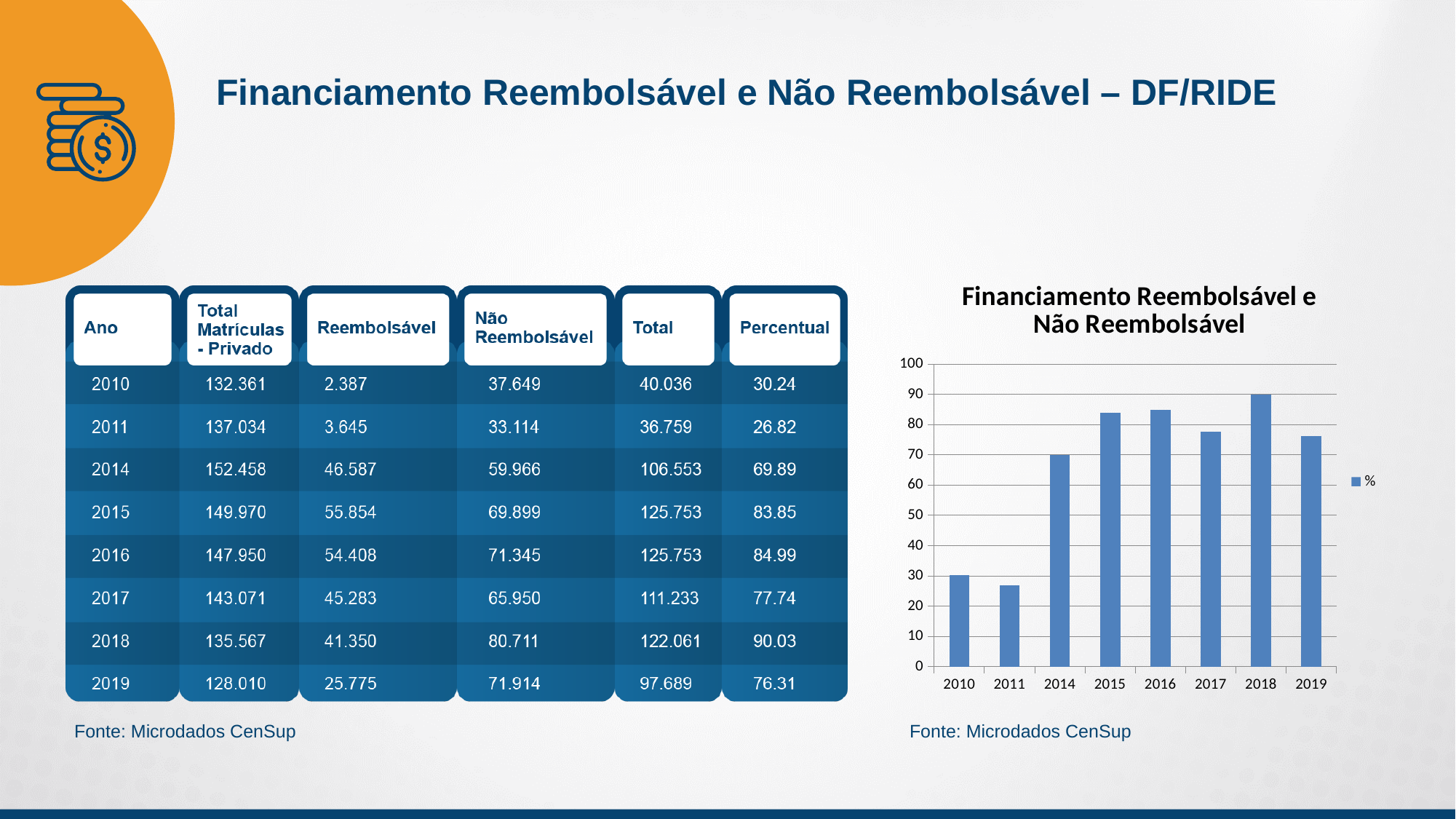
In the chart titled 'Financiamento Reembolsável e Não Reembolsável', which year has the highest bar? 2018 What is the legend entry shown in the chart on the right? % How many series does the legend of the chart on the right list? 1 What kind of chart is shown on the right side of the slide? bar chart In the chart on the right, is the value for 2010 greater or less than 40? less In the chart on the right, is the value for 2018 greater or less than 80? greater In the chart on the right, is the value for 2011 greater or less than 30? less In the chart titled 'Financiamento Reembolsável e Não Reembolsável', which year has the lowest bar? 2011 How many bars (years) are plotted in the chart on the right? 8 In the chart on the right, which bar is taller, 2014 or 2017? 2017 In the chart on the right, do the values rise or fall from 2010 to 2014? rise